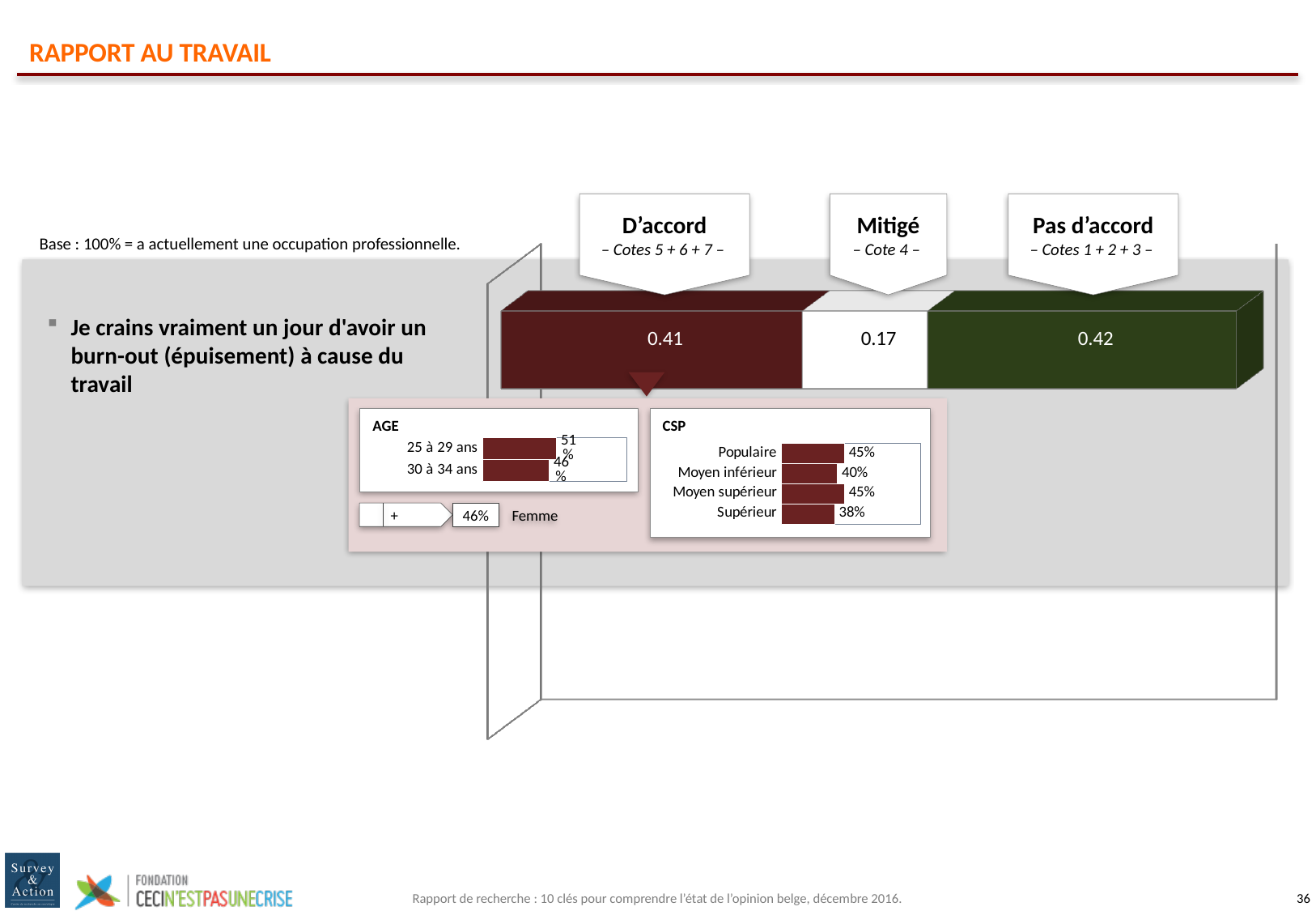
In the main stacked bar chart, which segment has the lowest value? Mitigé What type of chart is the CSP chart? Bar chart In the CSP chart, what is the value for 'Moyen inférieur'? 40% In the main stacked bar chart, how many segments make up the bar? 3 In the main stacked bar chart, what is the value for the 'D'accord' segment? 0.41 In the AGE chart, which category has the higher value, '25 à 29 ans' or '30 à 34 ans'? 25 à 29 ans In the CSP chart, which category has the lowest value? Supérieur In the AGE chart, what is the value for '25 à 29 ans'? 51% In the main stacked bar chart, what is the value for the 'Mitigé' segment? 0.17 In the main stacked bar chart, what is the difference between the 'Pas d'accord' and 'D'accord' values? 0.01 In the CSP chart, how many categories are shown? 4 In the main stacked bar chart, what is the value for the 'Pas d'accord' segment? 0.42